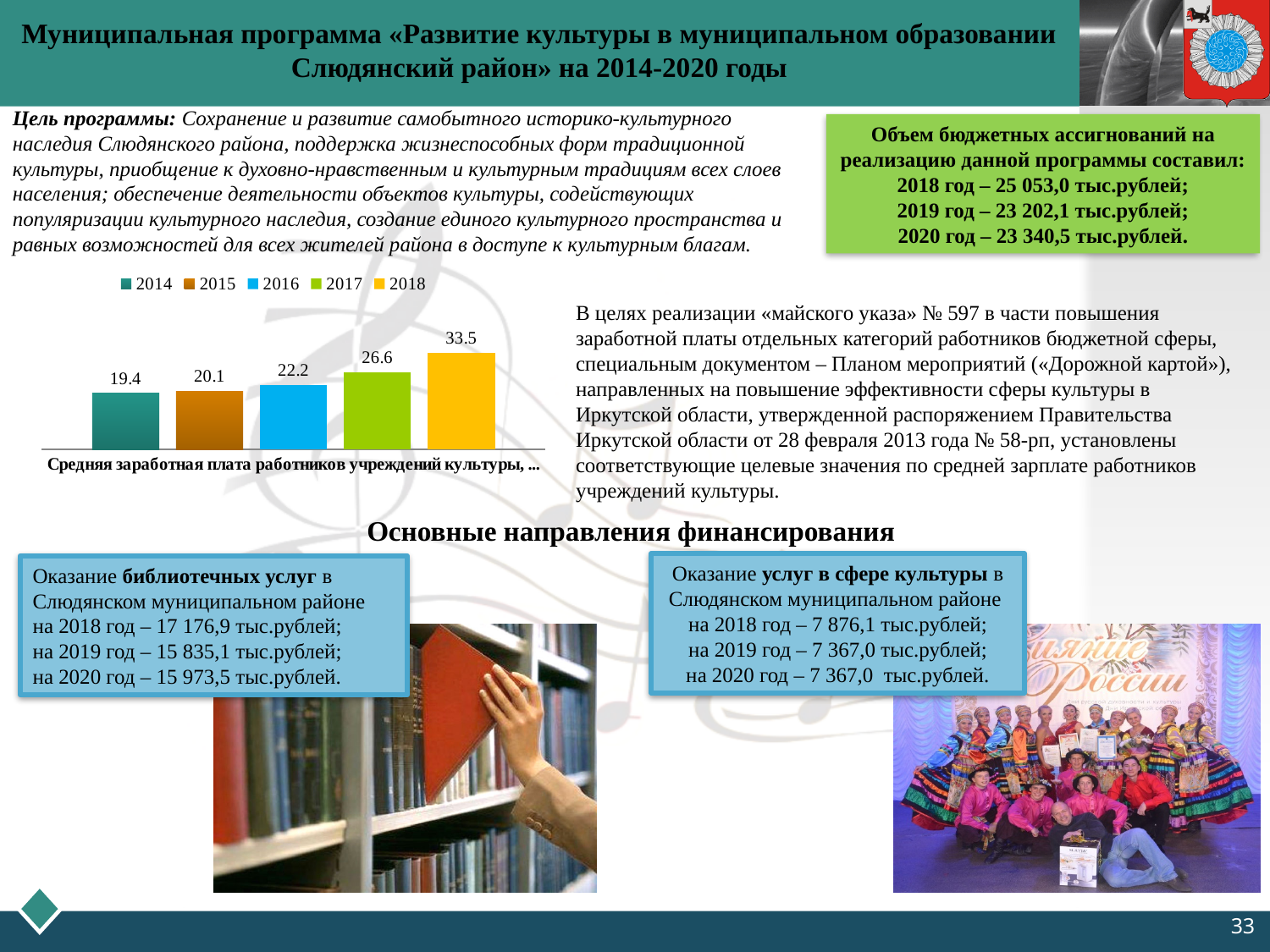
Do the values in the bar chart rise or fall from 2014 to 2018? Rise How many bars are plotted in the chart? 5 Which year has the lowest value in the bar chart? 2014 What is the value shown for 2016 in the bar chart? 22.2 Which is larger in the bar chart, the value for 2017 or the value for 2016? 2017 What is the difference between the values for 2018 and 2017 in the bar chart? 6.9 How many series does the chart legend list? 5 What kind of chart is shown on the slide? Bar chart What is the value shown for 2014 in the bar chart? 19.4 What is the difference between the values for 2015 and 2014 in the bar chart? 0.7 Which year has the highest value in the bar chart? 2018 What is the value shown for 2018 in the bar chart? 33.5